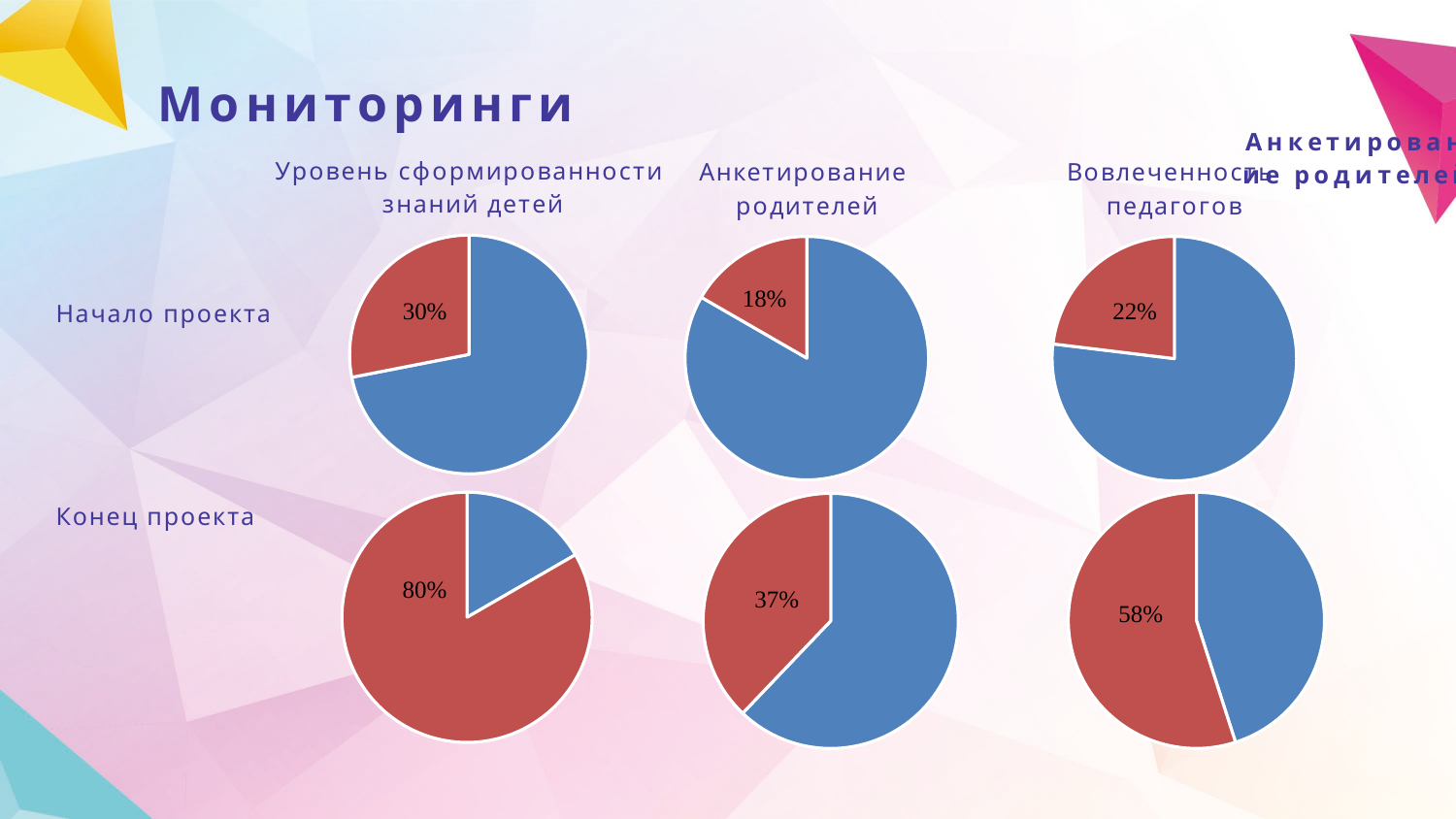
In the bottom-right pie chart (Вовлеченность педагогов, Конец проекта), what percentage is labelled on the red slice? 58% Among the three 'Конец проекта' pie charts, which one has the highest labelled percentage? Уровень сформированности знаний детей In the pie chart for 'Уровень сформированности знаний детей' at the start of the project (Начало проекта), what percentage is shown on the red slice? 30% Among the three 'Начало проекта' pie charts, which one has the lowest labelled percentage? Анкетирование родителей In the top-right pie chart (Вовлеченность педагогов, Начало проекта), what percentage is labelled on the red slice? 22% What type of chart is used on this slide? Pie chart For the right-hand column of charts (Вовлеченность педагогов), what is the difference between the end-of-project and start-of-project labelled values? 36 In the pie chart for 'Уровень сформированности знаний детей' at the end of the project (Конец проекта), what percentage is shown on the red slice? 80% In the pie chart for 'Анкетирование родителей' at the end of the project (Конец проекта), what percentage is labelled? 37% For 'Анкетирование родителей', what is the difference between the end-of-project value and the start-of-project value? 19 In the pie chart for 'Анкетирование родителей' at the start of the project (Начало проекта), what percentage is labelled? 18% For 'Уровень сформированности знаний детей', by how many percentage points did the labelled value increase from the start to the end of the project? 50